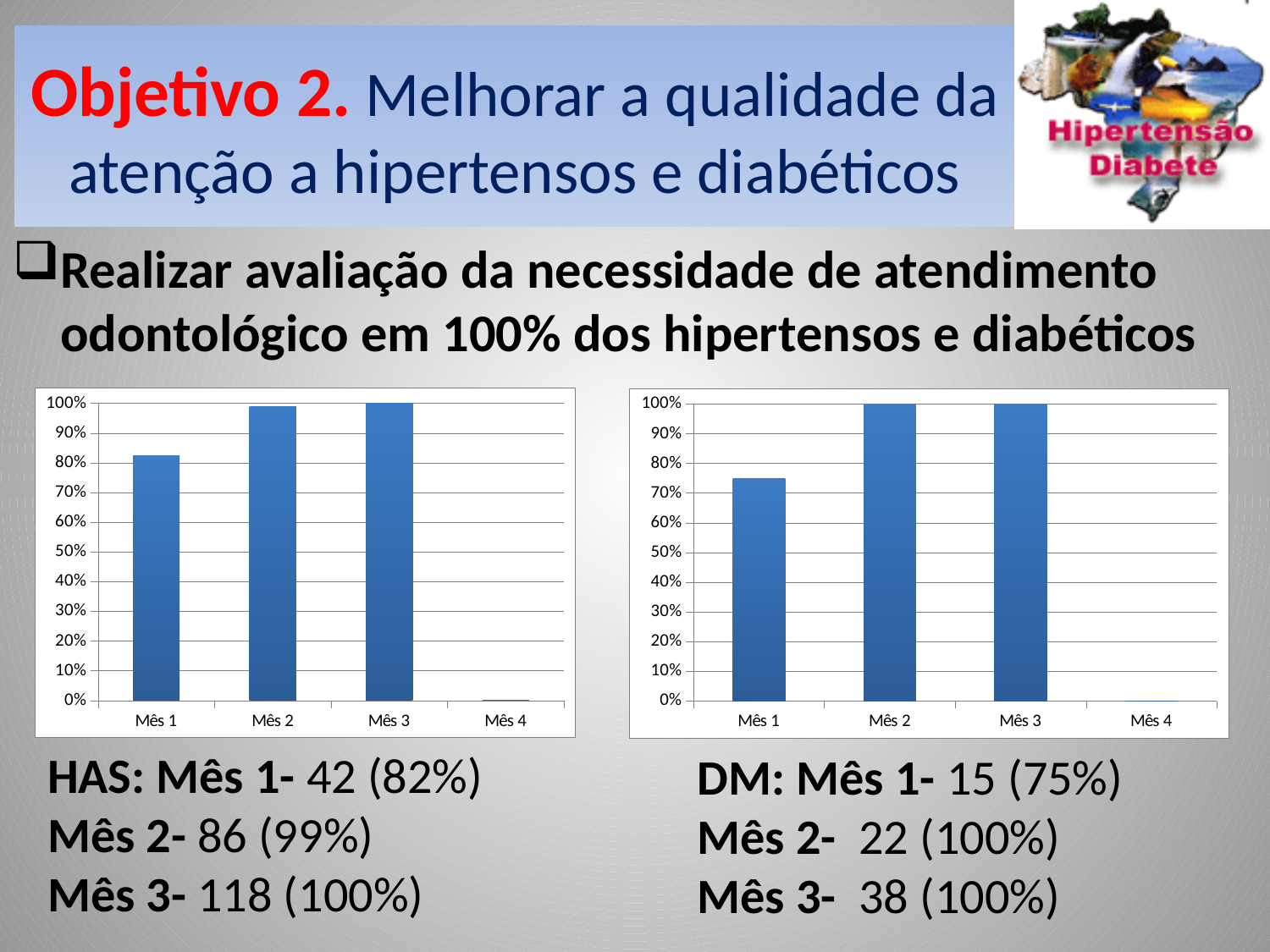
In the left chart, which month has the lowest value? Mês 4 In the right chart, which is larger, the value for Mês 1 or the value for Mês 3? Mês 3 In the left chart, which is larger, the value for Mês 1 or the value for Mês 2? Mês 2 In the right chart, which month has the lowest value? Mês 4 In the left chart, what is the value for Mês 3? 100% How many categories are shown on the x axis of the right chart? 4 In the right chart, what is the value for Mês 2? 100% In the left chart, is the value for Mês 1 greater or less than 80%? greater In the right chart, is the value for Mês 1 greater or less than 80%? less What colour are the bars in both charts? blue In the right chart, do the values rise or fall from Mês 1 to Mês 2? rise What kind of chart is the left chart on the slide? bar chart